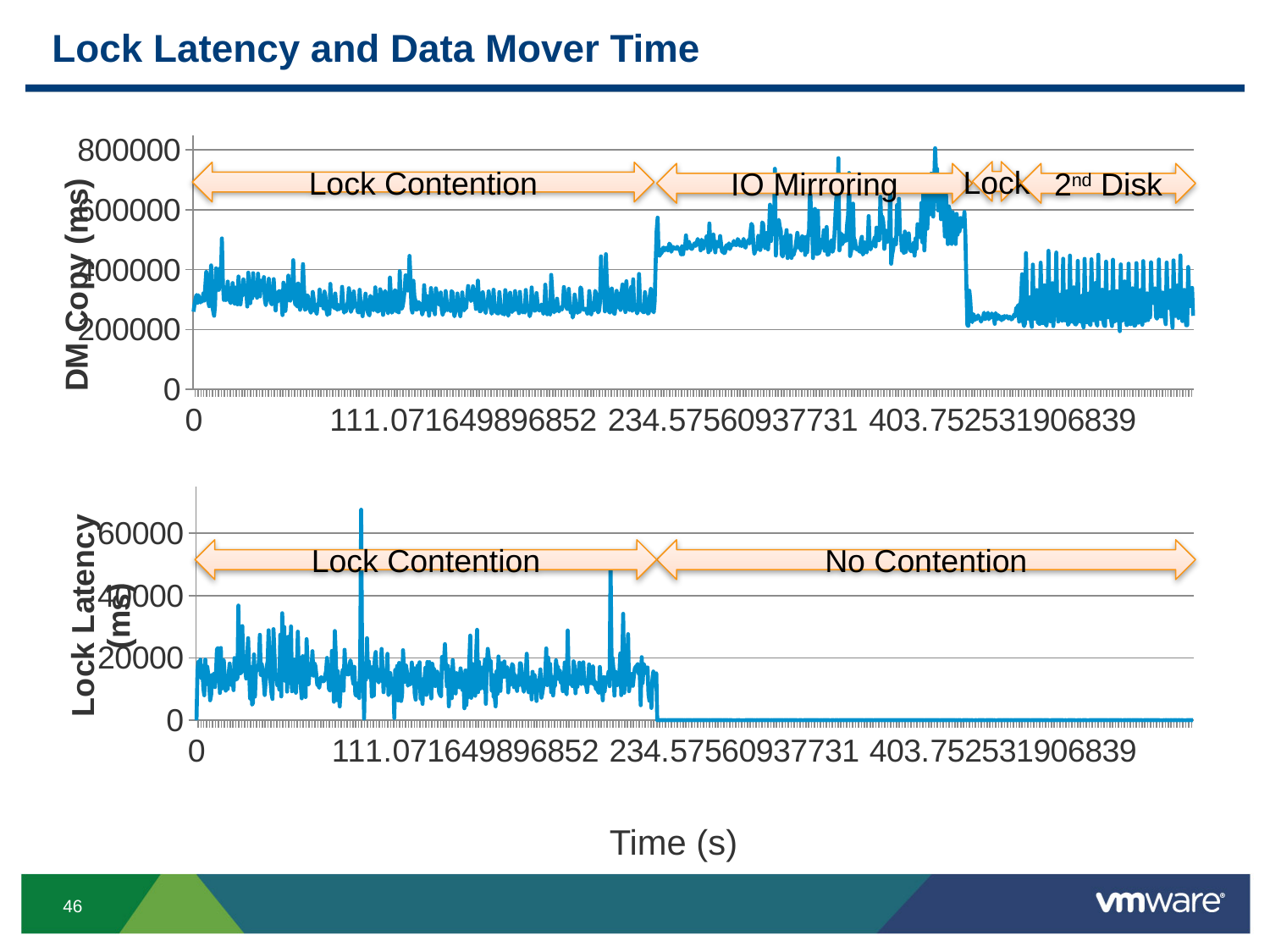
In the top chart (DM Copy), do the values rise or fall when moving from the Lock Contention phase into the IO Mirroring phase? rise What kind of chart is the bottom chart (Lock Latency) on the slide? line chart What is the label of the shared x axis for both charts? Time (s) In the bottom chart (Lock Latency), is the highest spike greater or less than 60000? greater In the top chart (DM Copy), which phase has higher values: Lock Contention or IO Mirroring? IO Mirroring What is the title of the slide containing the two charts? Lock Latency and Data Mover Time In the bottom chart (Lock Latency), do the values rise or fall when moving from the Lock Contention phase to the No Contention phase? fall In the bottom chart (Lock Latency), is the value during the No Contention phase greater or less than 20000? less In the top chart (DM Copy), is the value at time 0 greater or less than 600000? less What is the highest tick value shown on the y axis of the top chart (DM Copy)? 800000 What kind of chart is the top chart (DM Copy) on the slide? line chart